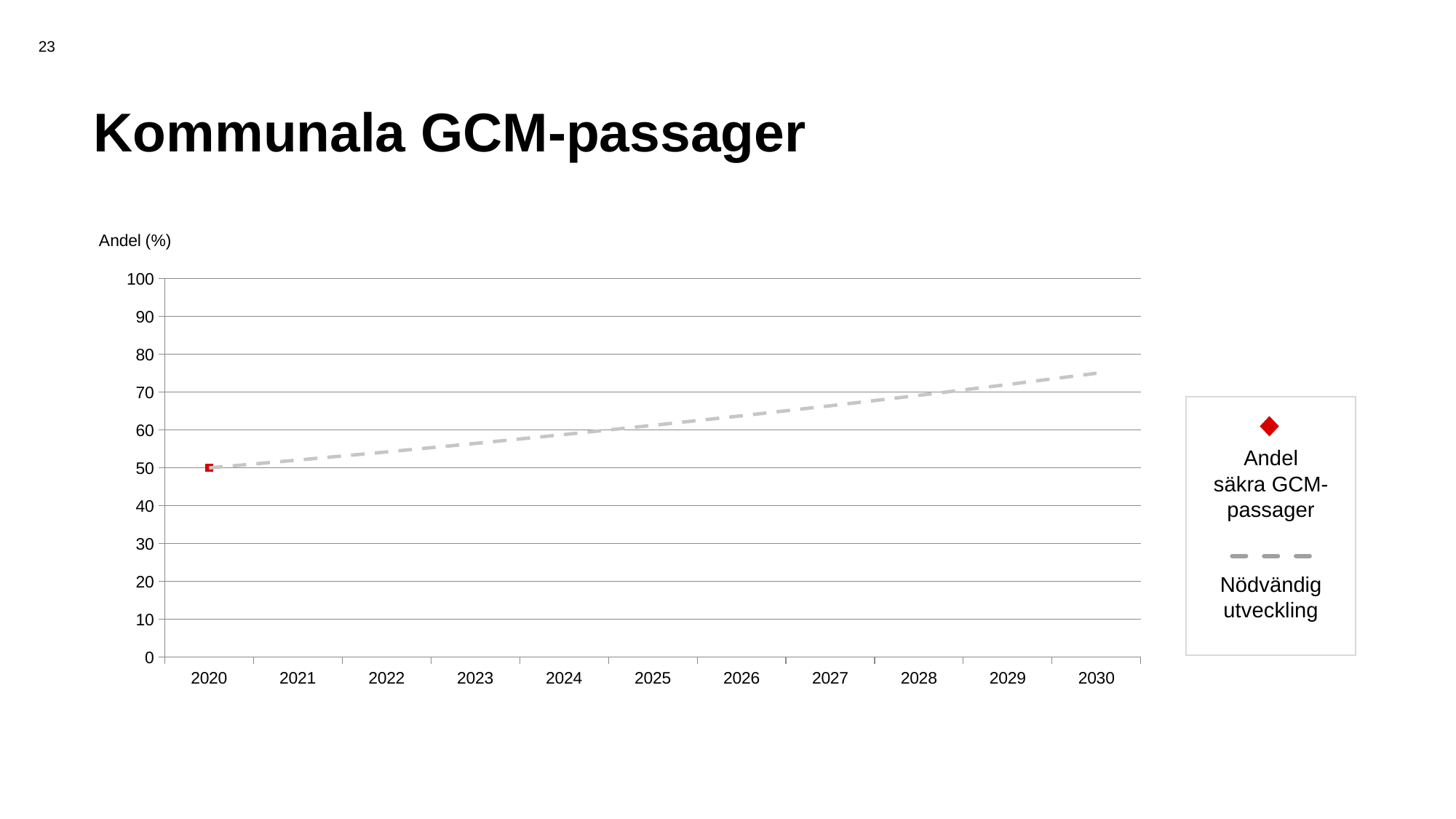
How many series does the legend list? 2 What kind of chart is shown on the slide? line chart How many years are labelled on the x axis? 11 What is the title of the chart? Kommunala GCM-passager What is the value of Andel säkra GCM-passager in 2020? 50 Is the value of Nödvändig utveckling in 2028 greater or less than 60? greater Is the value of Nödvändig utveckling in 2025 greater or less than 70? less Is the value of Nödvändig utveckling in 2030 greater or less than 80? less What is the value of the Nödvändig utveckling line in 2020? 50 What is the label of the y axis? Andel (%) Does the Nödvändig utveckling line rise or fall from 2020 to 2030? rise